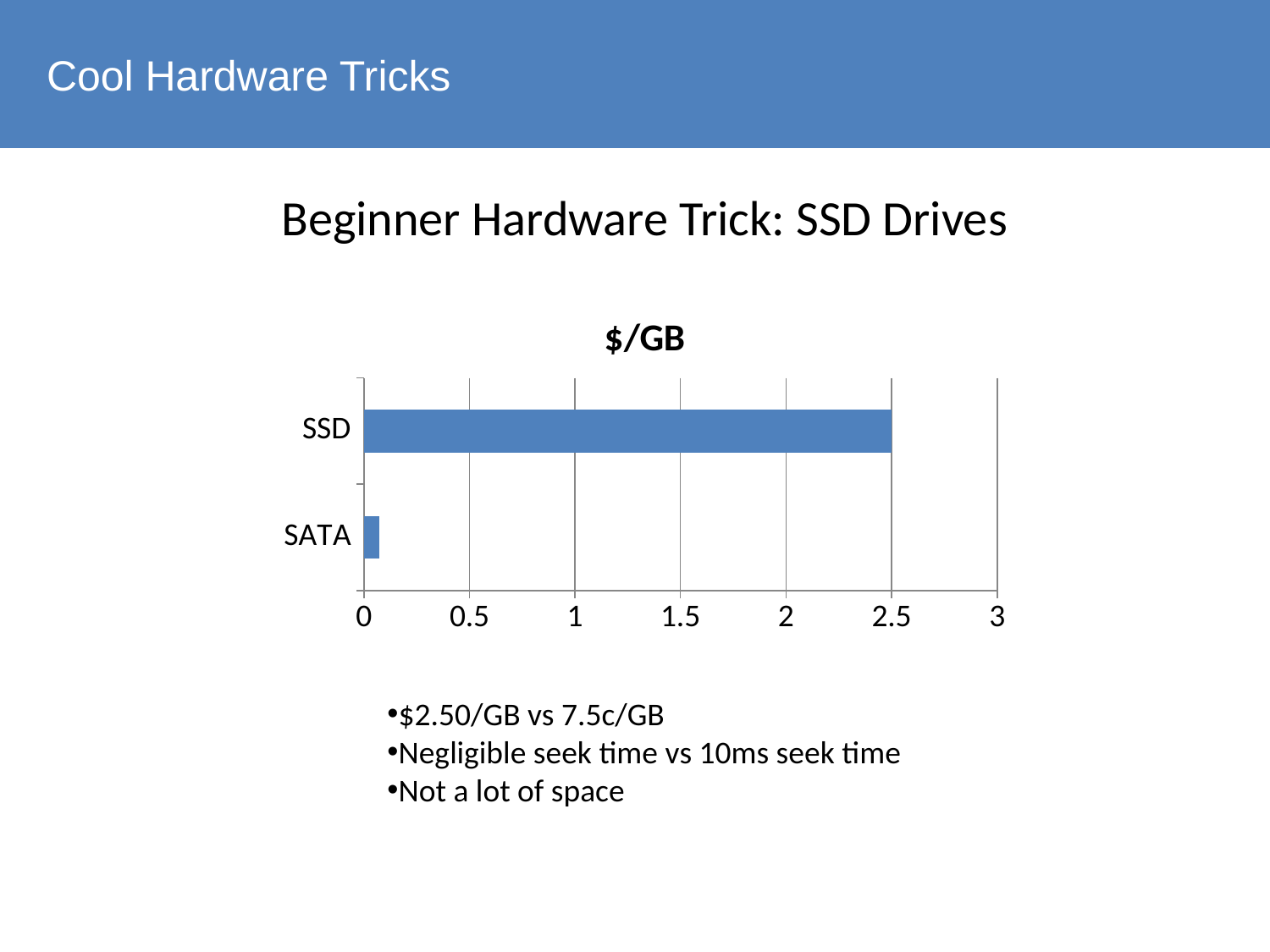
Which has a larger $/GB value, SSD or SATA? SSD Is the value for SSD greater or less than 2? greater What type of chart is shown on the slide? bar chart What is the title of the chart? $/GB Which category has the lowest value in the $/GB chart? SATA Is the value for SSD greater or less than 3? less How many categories are plotted in the chart? 2 Is the value for SATA greater or less than 0.5? less What is the value for SSD in the $/GB chart? 2.5 Which category has the highest value in the $/GB chart? SSD What is the maximum value shown on the horizontal axis of the chart? 3